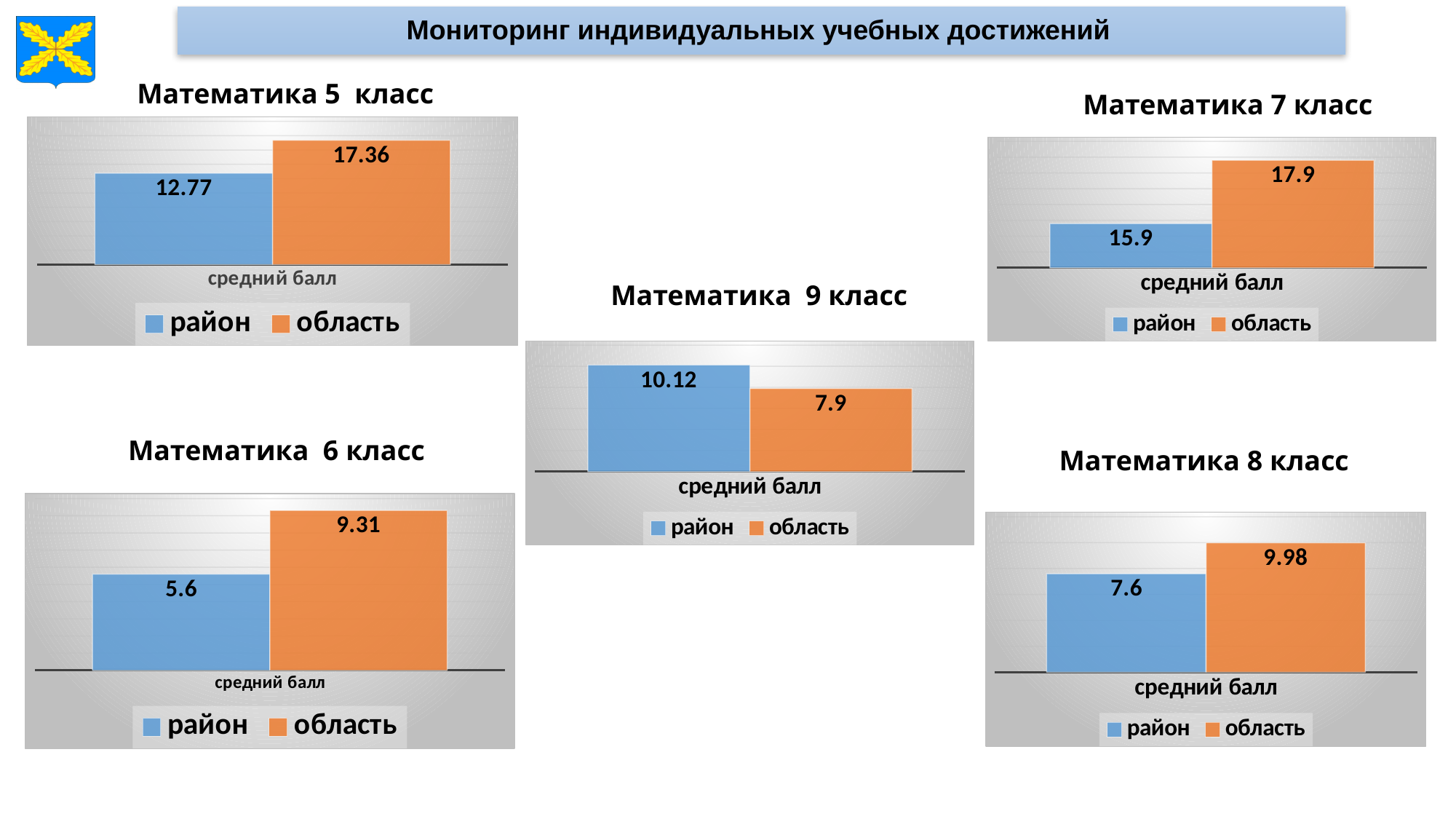
What kind of chart is 'Математика 7 класс'? bar chart In the 'Математика 8 класс' chart, what is the value for область? 9.98 In the 'Математика 9 класс' chart, what is the value for район? 10.12 In the 'Математика 5 класс' chart, what is the value for район? 12.77 In the 'Математика 7 класс' chart, which series is higher, район or область? область In the 'Математика 9 класс' chart, which series has the lower value? область How many series does the legend of the 'Математика 6 класс' chart list? 2 In the 'Математика 6 класс' chart, what is the difference between область and район? 3.71 What is the x-axis category label in the 'Математика 9 класс' chart? средний балл In the 'Математика 5 класс' chart, what is the value for область? 17.36 In the 'Математика 7 класс' chart, what is the value for район? 15.9 In the 'Математика 8 класс' chart, what is the difference between область and район? 2.38